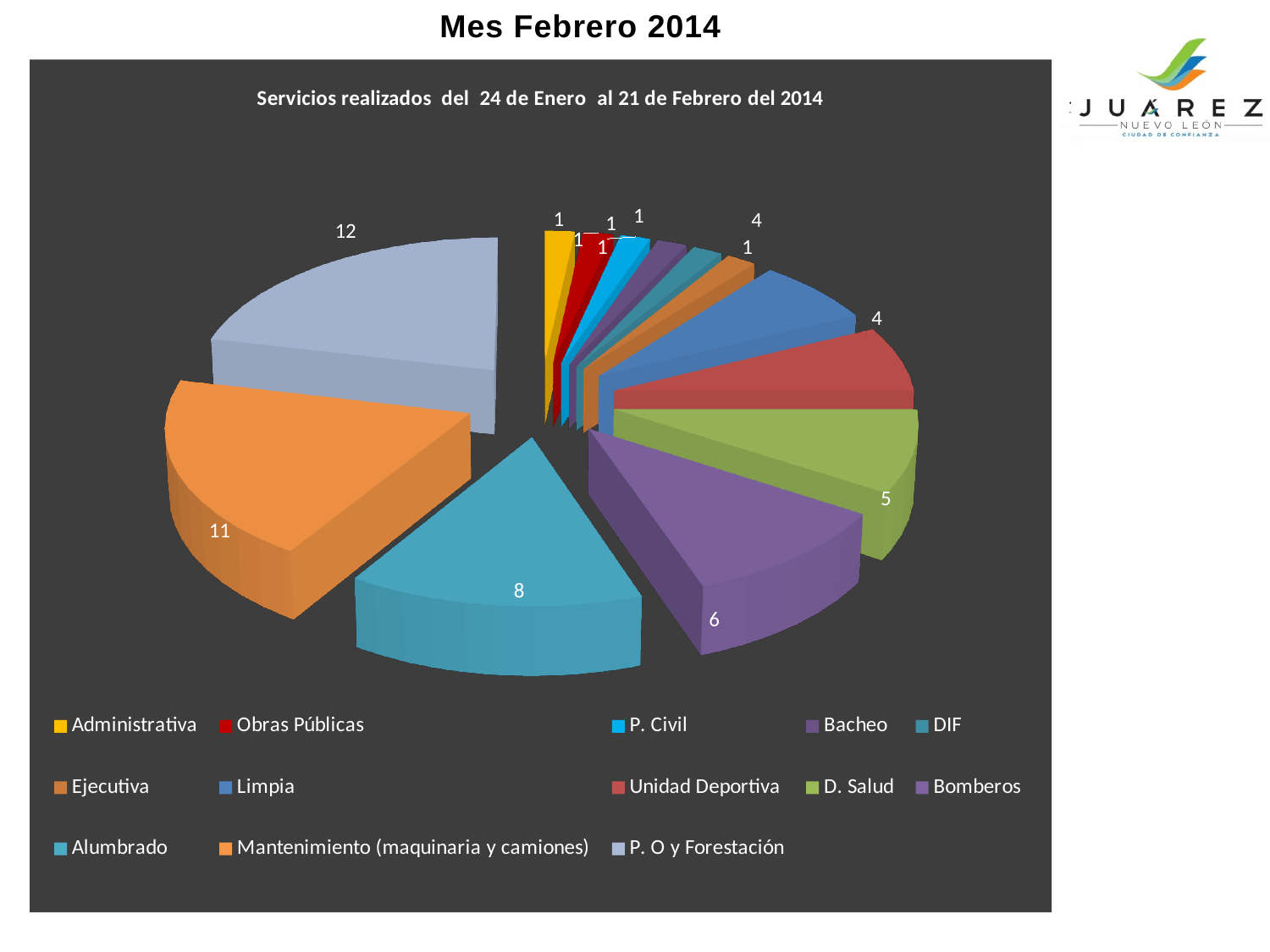
Which is larger, the value for Bomberos or the value for D. Salud? Bomberos What type of chart is shown on the slide? Pie chart What is the value for Alumbrado? 8 What is the value for D. Salud? 5 What is the title of the chart? Servicios realizados del 24 de Enero al 21 de Febrero del 2014 Which category has the largest slice of the pie? P. O y Forestación What is the difference between the values for Mantenimiento (maquinaria y camiones) and Alumbrado? 3 How many categories does the legend of the pie chart list? 13 What is the value for Administrativa? 1 What is the value for Bomberos? 6 What is the value for P. O y Forestación? 12 What is the value for Mantenimiento (maquinaria y camiones)? 11